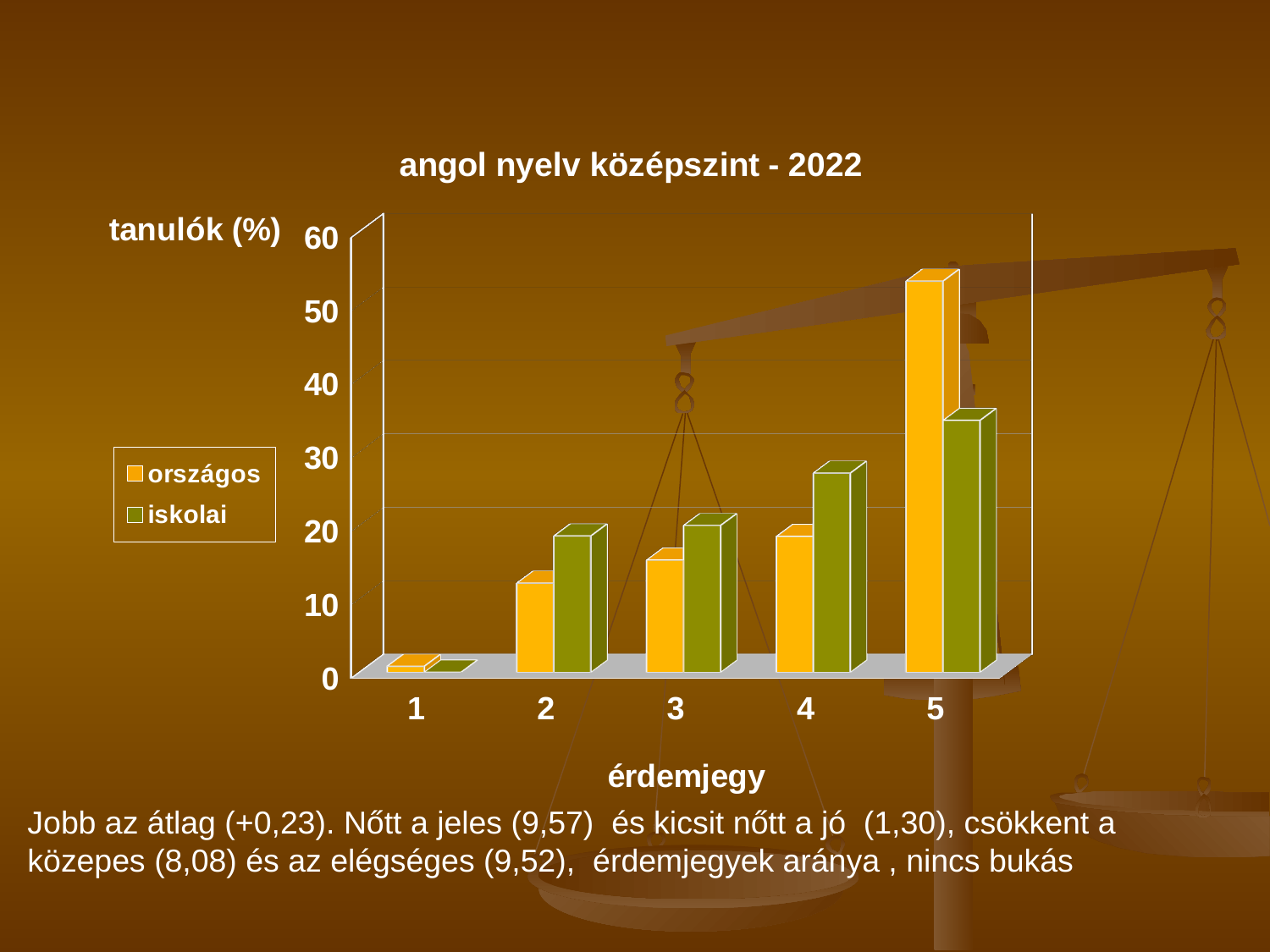
Is the országos value for érdemjegy 2 greater or less than 20? less For which érdemjegy is the országos value highest? 5 Which two series are listed in the legend? országos, iskolai What is the title of the chart? angol nyelv középszint - 2022 For érdemjegy 4, which series has the larger value, országos or iskolai? iskolai What kind of chart is shown on the slide? bar chart How many series does the legend list? 2 Do the országos values rise or fall as érdemjegy goes from 1 to 5? rise How many érdemjegy categories are shown on the x axis? 5 For érdemjegy 5, which series has the larger value, országos or iskolai? országos For which érdemjegy is the iskolai value lowest? 1 Is the országos value for érdemjegy 5 greater or less than 50? greater